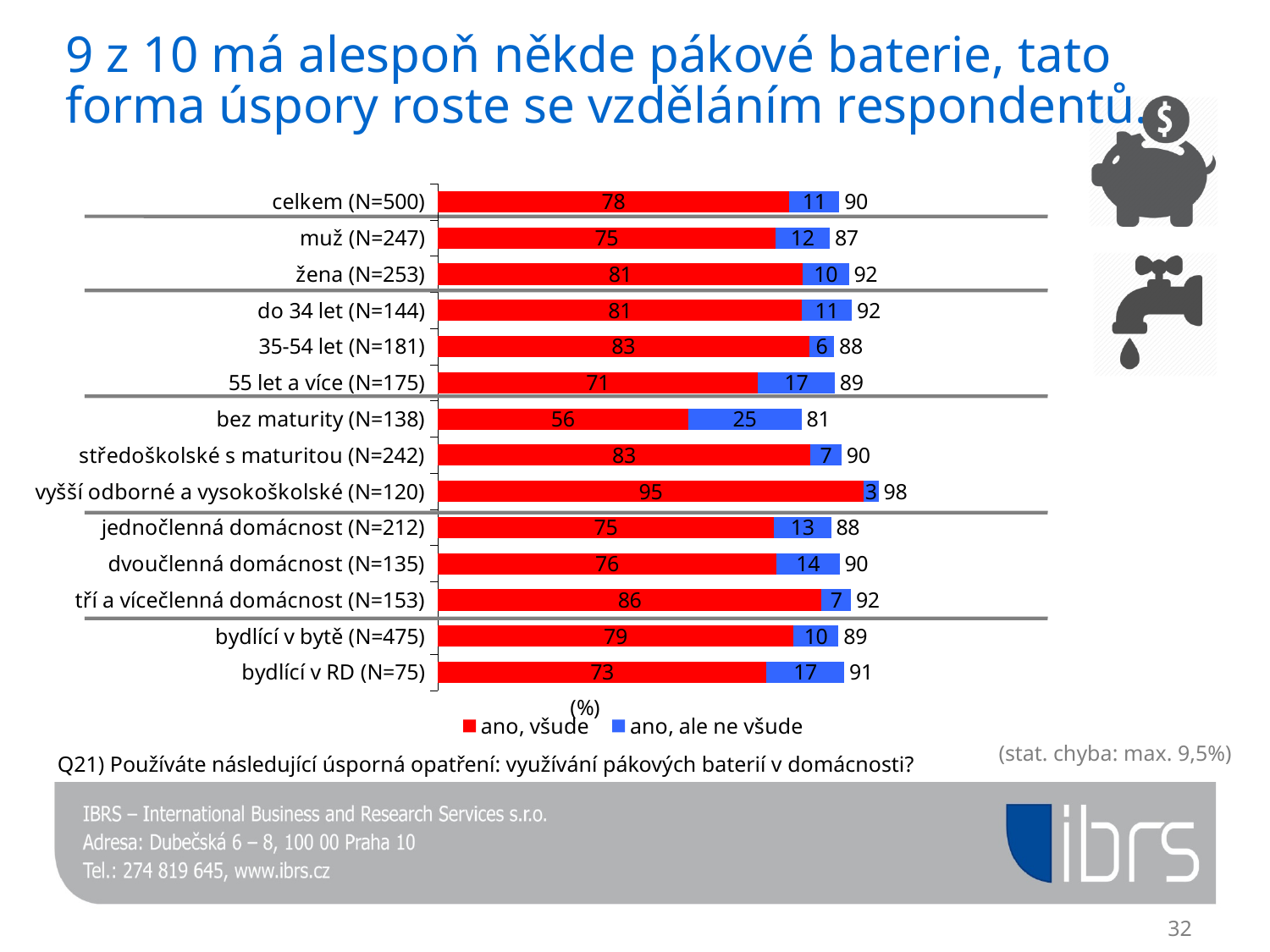
What is the value of "ano, všude" for celkem (N=500)? 78 What is the difference between the "ano, všude" values for žena (N=253) and muž (N=247)? 6 What is the total shown at the end of the bar for vyšší odborné a vysokoškolské (N=120)? 98 Which category has the lowest value for "ano, všude"? bez maturity (N=138) How many categories are plotted in the chart? 14 Which category has the highest value for "ano, všude"? vyšší odborné a vysokoškolské (N=120) Which has a larger "ano, ale ne všude" value: 55 let a více (N=175) or 35-54 let (N=181)? 55 let a více (N=175) Which colour represents the series "ano, ale ne všude"? blue What is the value of "ano, ale ne všude" for bez maturity (N=138)? 25 How many series does the legend list? 2 What is the total for bydlící v RD (N=75)? 91 What kind of chart is shown on the slide? stacked bar chart